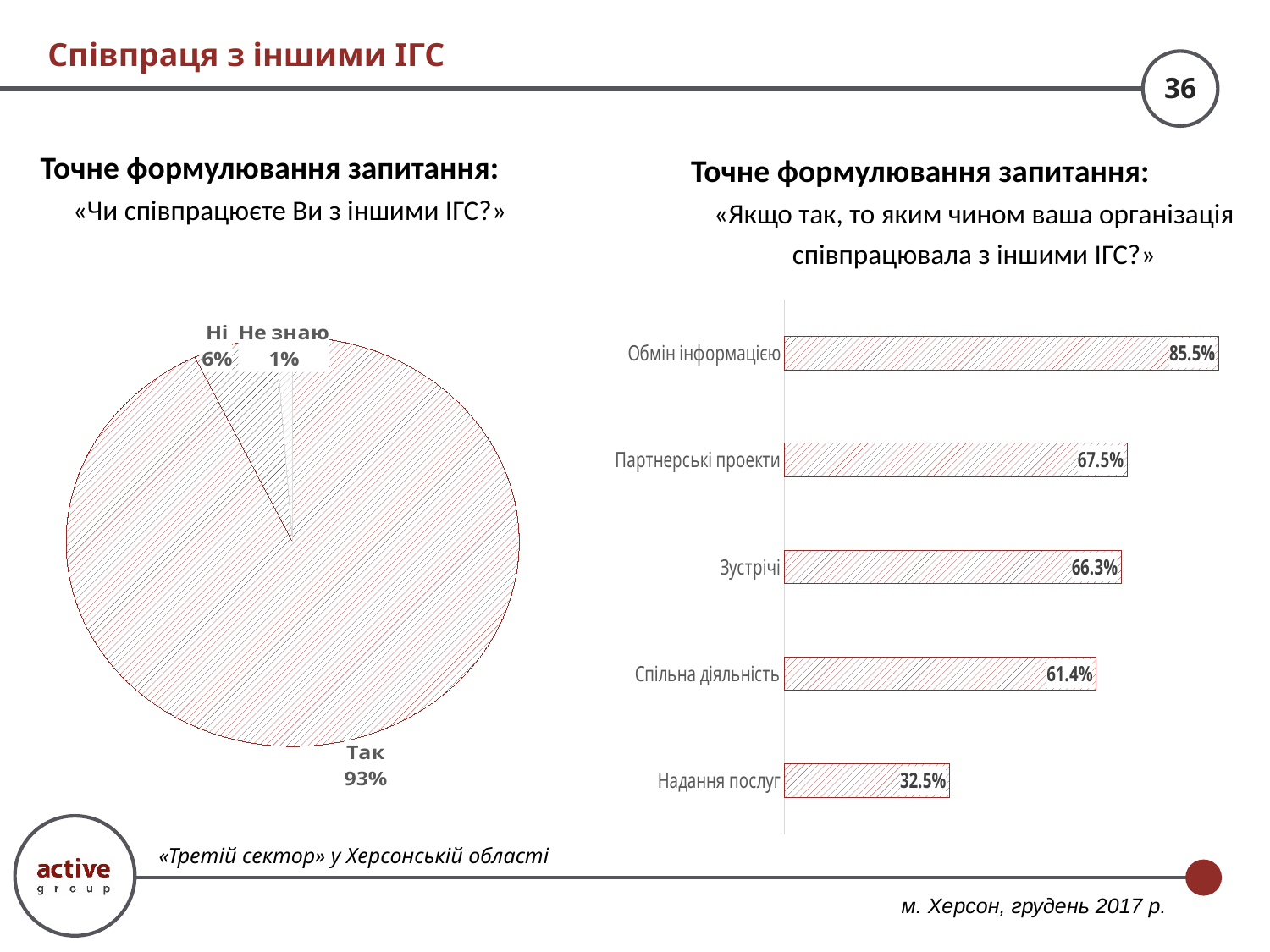
In the bar chart on the right, which category has the lowest value? Надання послуг In the bar chart on the right, what is the difference between «Обмін інформацією» and «Спільна діяльність»? 24.1% In the pie chart on the left, which answer has the smallest slice? Не знаю In the bar chart on the right, which category has the highest value? Обмін інформацією How many slices does the pie chart on the left have? 3 In the bar chart on the right, what is the value for «Надання послуг»? 32.5% In the pie chart on the left, what share of respondents answered «Так»? 93% In the bar chart on the right, which is larger: «Зустрічі» or «Спільна діяльність»? Зустрічі How many categories are shown in the bar chart on the right? 5 What kind of chart is shown on the left side of the slide? Pie chart In the pie chart on the left, what share of respondents answered «Ні»? 6% In the bar chart on the right, what is the value for «Партнерські проекти»? 67.5%